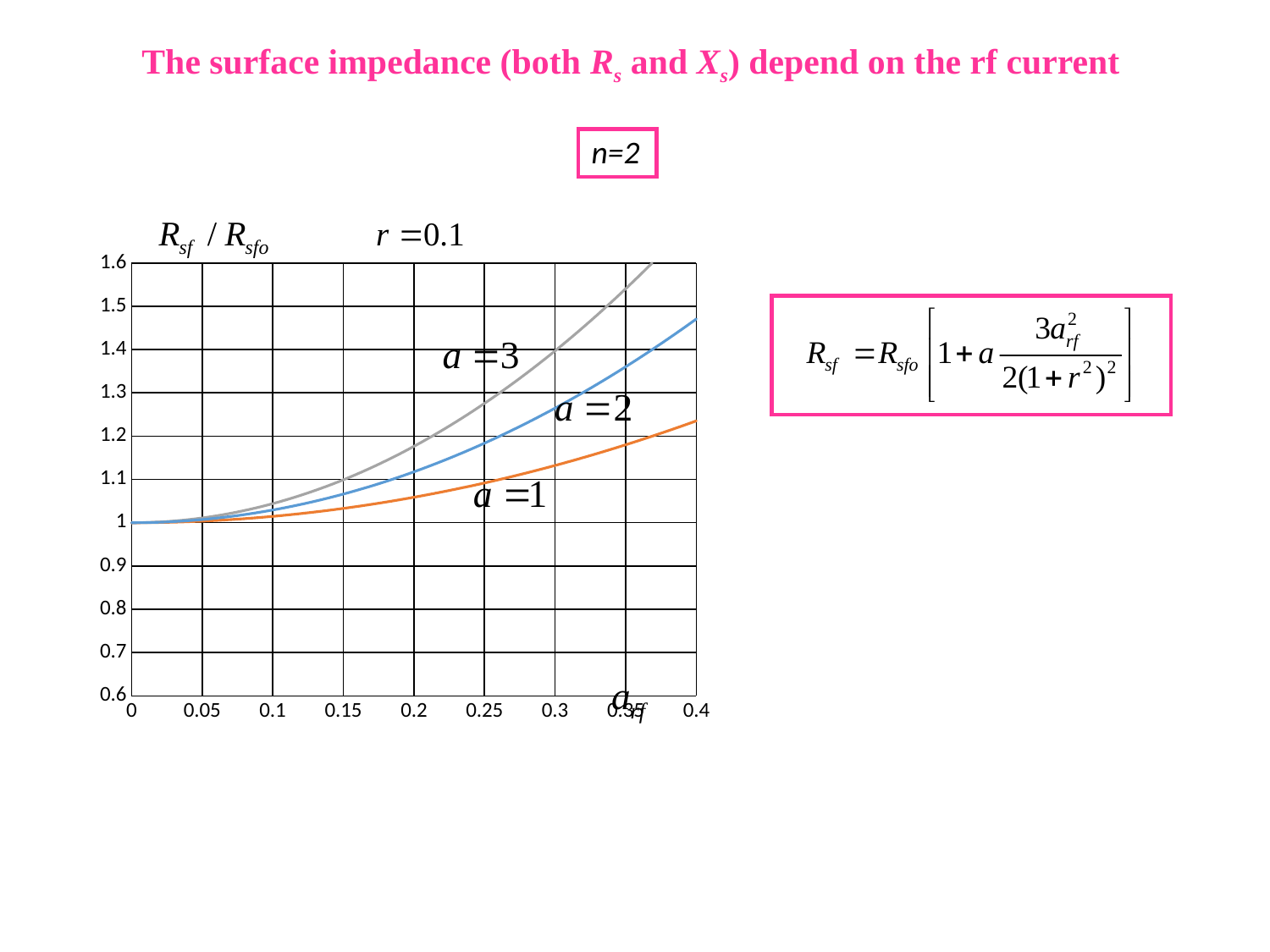
Which curve has the highest value at a_rf = 0.3? a = 3 Do the curves rise or fall as a_rf increases? rise At a_rf = 0.35, which is larger: the a = 3 curve or the a = 1 curve? a = 3 At a_rf = 0.4, is the value of the a = 1 curve greater or less than 1.3? less What is the maximum value shown on the y axis of the chart? 1.6 At a_rf = 0.25, is the value of the a = 3 curve greater or less than 1.2? greater At a_rf = 0.4, is the value of the a = 2 curve greater or less than 1.4? greater What kind of chart is shown on the slide? line chart What is the value of R_sf/R_sfo at a_rf = 0 for the a = 1 curve? 1 How many curves are plotted on the chart? 3 Which curve has the lowest value at a_rf = 0.3? a = 1 What value of r is stated above the chart? r = 0.1